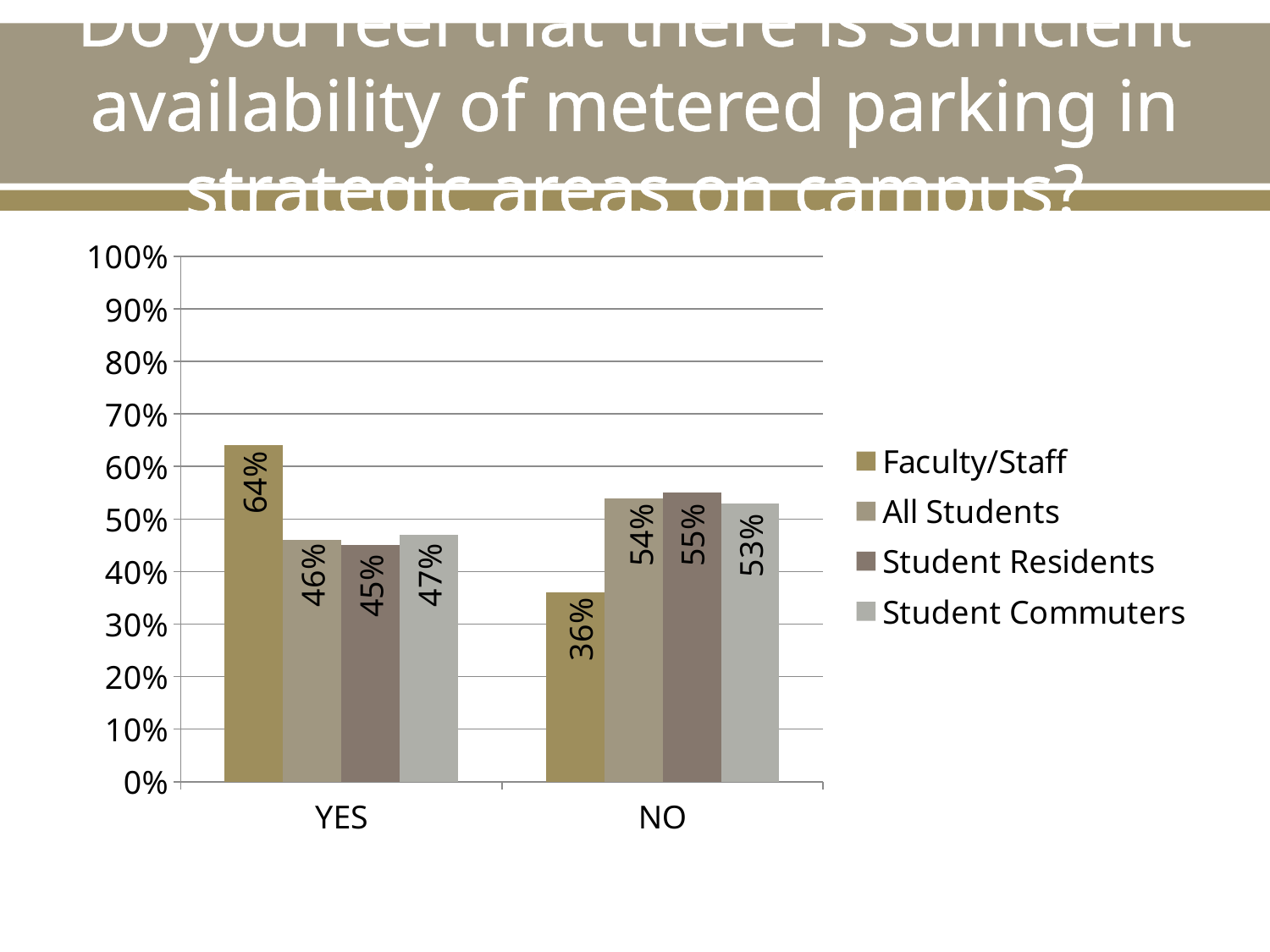
How many categories are shown on the x axis? 2 What percentage of All Students answered NO? 54% What percentage of Faculty/Staff answered YES? 64% Which series has the lowest value in the NO category? Faculty/Staff What kind of chart is shown on the slide? Bar chart What is the difference between the Faculty/Staff YES value and the Faculty/Staff NO value? 28% What percentage of Student Residents answered NO? 55% Which series has the highest value in the YES category? Faculty/Staff How many series does the legend list? 4 Which is larger: the Faculty/Staff YES value or the All Students YES value? Faculty/Staff YES What percentage of Student Commuters answered YES? 47% Is the Faculty/Staff NO value greater or less than 40%? less